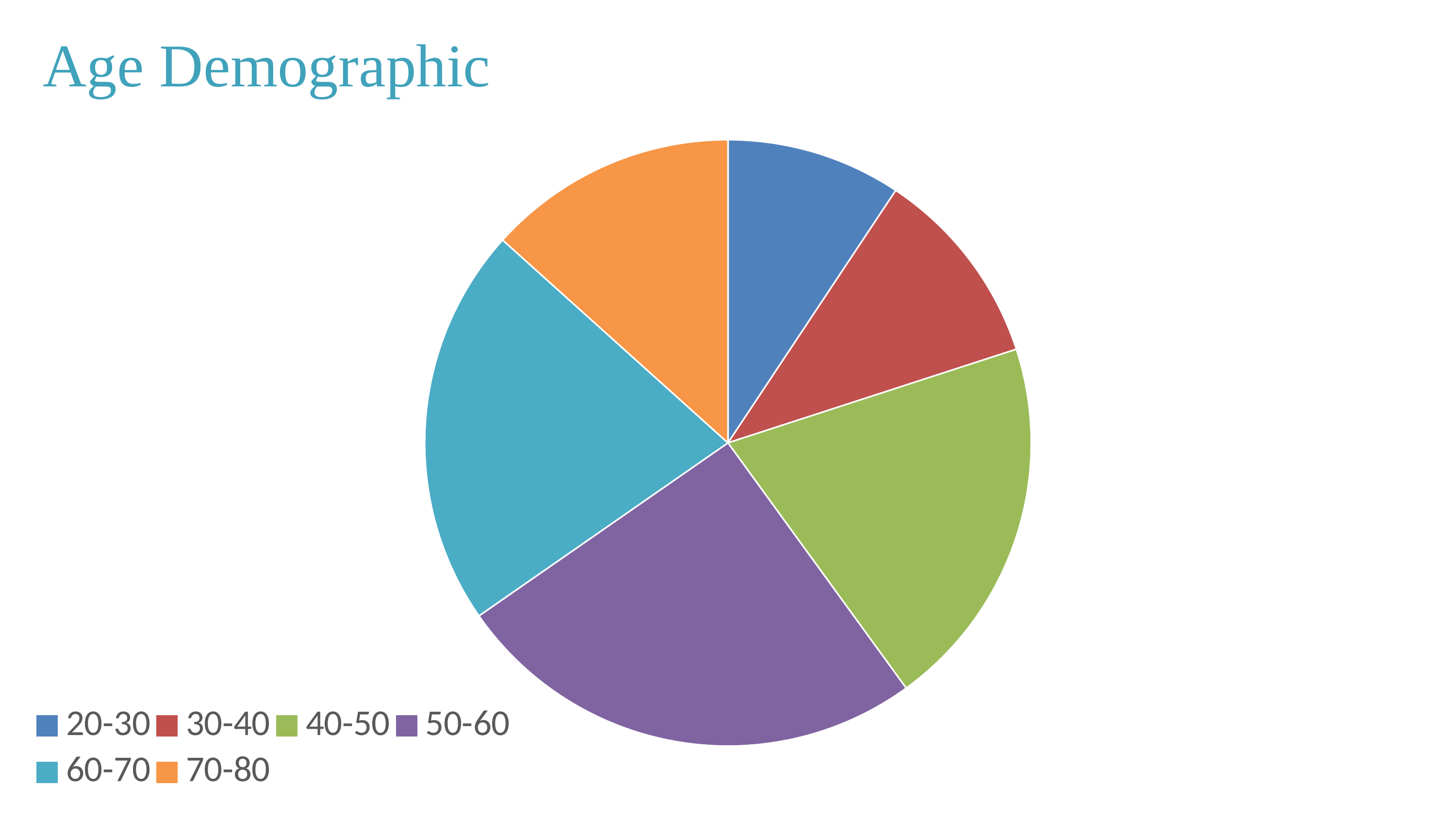
Which slice is larger, 60-70 or 30-40? 60-70 How many age groups (slices) does the pie chart show? 6 Which slice is larger, 40-50 or 20-30? 40-50 What colour is the slice for the 50-60 age group? purple What is the title of the slide containing the pie chart? Age Demographic Which slice is larger, 50-60 or 30-40? 50-60 What kind of chart is shown on the slide? pie chart Which age group has the largest slice of the pie? 50-60